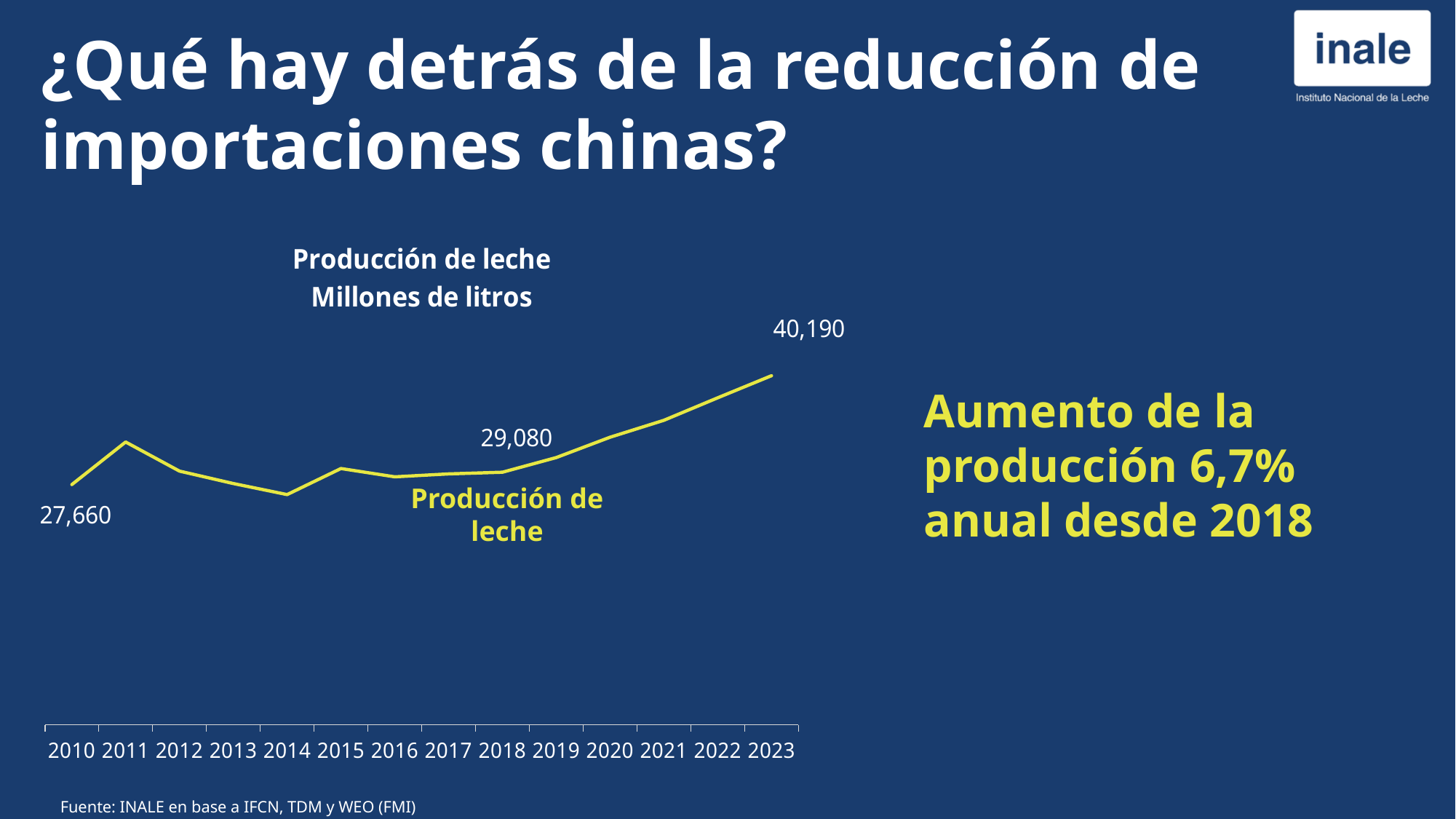
Which year has the highest milk production on the chart? 2023 Which year has the lowest milk production on the chart? 2014 By how much did milk production increase from 2018 to 2023? 11,110 What is the milk production value shown for 2023? 40,190 In what unit is milk production expressed according to the chart title? Millones de litros How many years are shown on the x axis of the chart? 14 Do the values rise or fall between 2018 and 2023? rise What is the milk production value shown for 2010? 27,660 What kind of chart is shown on the slide? line chart What is the difference between the 2023 value and the 2010 value? 12,530 Which is larger, the value for 2010 or the value for 2018? 2018 What is the milk production value shown for 2018? 29,080